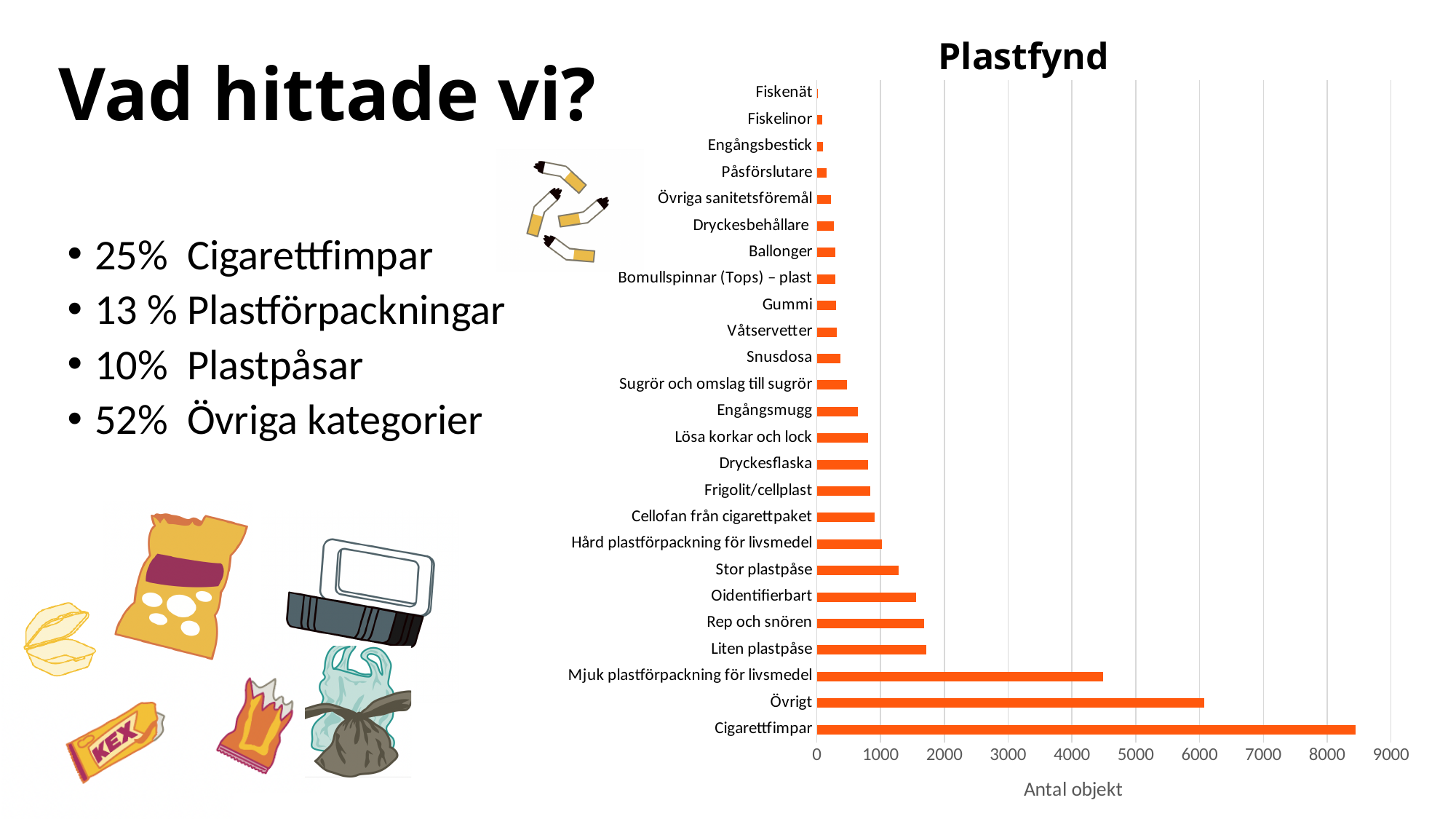
Is the value for Mjuk plastförpackning för livsmedel greater or less than 4000? greater Which is larger, the value for Övrigt or the value for Mjuk plastförpackning för livsmedel? Övrigt Is the value for Liten plastpåse greater or less than 2000? less What is the title of the chart? Plastfynd How many categories are plotted in the chart? 25 What kind of chart is shown on the slide? bar chart Which category has the highest value in the chart? Cigarettfimpar What is the label of the horizontal axis of the chart? Antal objekt Which category has the lowest value in the chart? Fiskenät Is the value for Övrigt greater or less than 7000? less